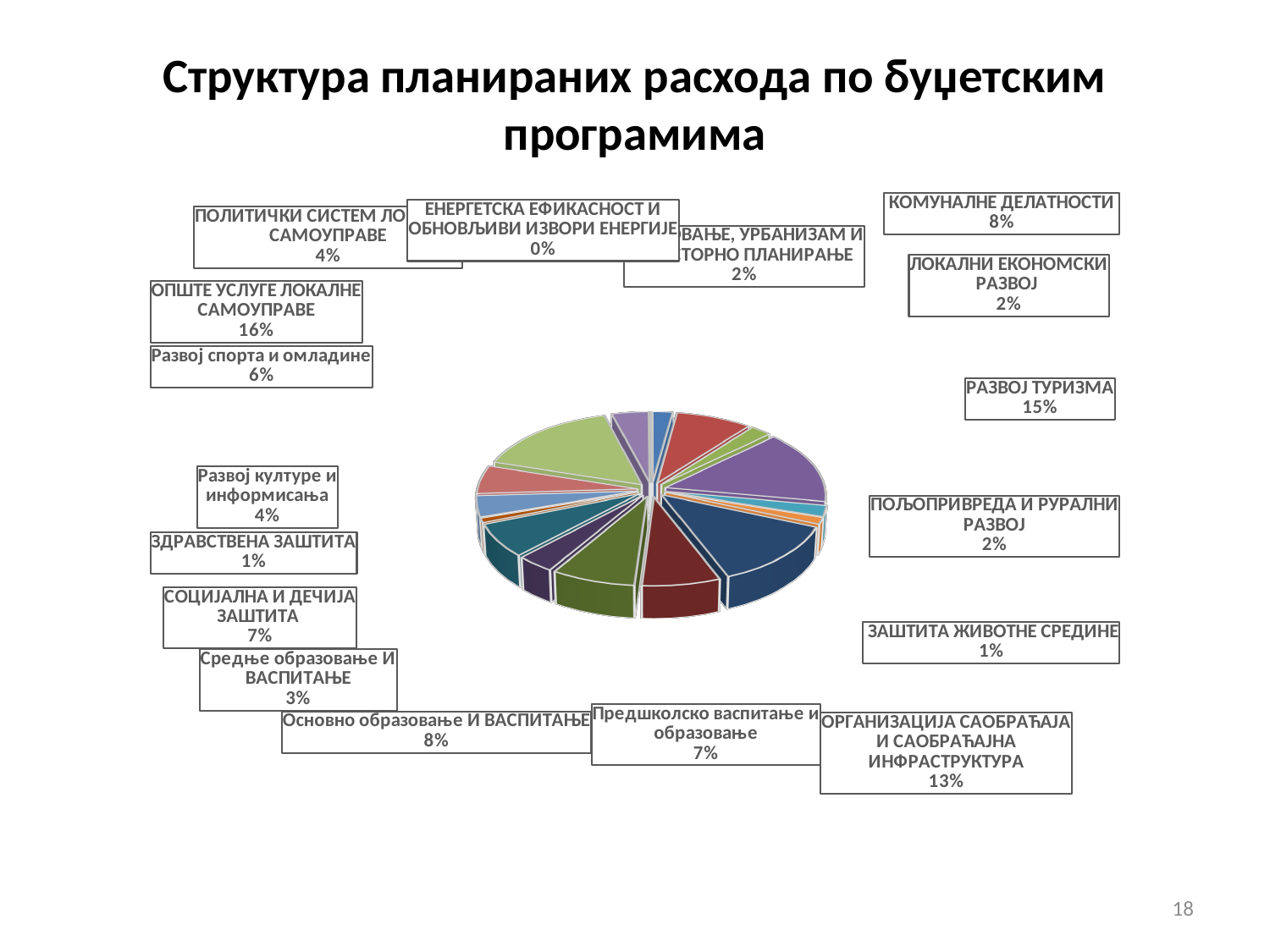
What is the difference in percentage points between ОПШТЕ УСЛУГЕ ЛОКАЛНЕ САМОУПРАВЕ and РАЗВОЈ ТУРИЗМА? 1 percentage point Which budget programme has the smallest share, labelled 0%? ЕНЕРГЕТСКА ЕФИКАСНОСТ И ОБНОВЉИВИ ИЗВОРИ ЕНЕРГИЈЕ What share is shown for РАЗВОЈ ТУРИЗМА? 15% What percentage is labelled for ОРГАНИЗАЦИЈА САОБРАЋАЈА И САОБРАЋАЈНА ИНФРАСТРУКТУРА? 13% What kind of chart is shown on the slide? Pie chart Which has a larger share: РАЗВОЈ ТУРИЗМА or ОРГАНИЗАЦИЈА САОБРАЋАЈА И САОБРАЋАЈНА ИНФРАСТРУКТУРА? РАЗВОЈ ТУРИЗМА Which budget programme has the largest share of planned expenditures? ОПШТЕ УСЛУГЕ ЛОКАЛНЕ САМОУПРАВЕ What share is shown for КОМУНАЛНЕ ДЕЛАТНОСТИ? 8% What percentage is labelled for Предшколско васпитање и образовање? 7% What share of planned expenditures goes to ОПШТЕ УСЛУГЕ ЛОКАЛНЕ САМОУПРАВЕ? 16% What is the title of the chart on the slide? Структура планираних расхода по буџетским програмима Which has a larger share: СОЦИЈАЛНА И ДЕЧИЈА ЗАШТИТА or Средње образовање И ВАСПИТАЊЕ? СОЦИЈАЛНА И ДЕЧИЈА ЗАШТИТА